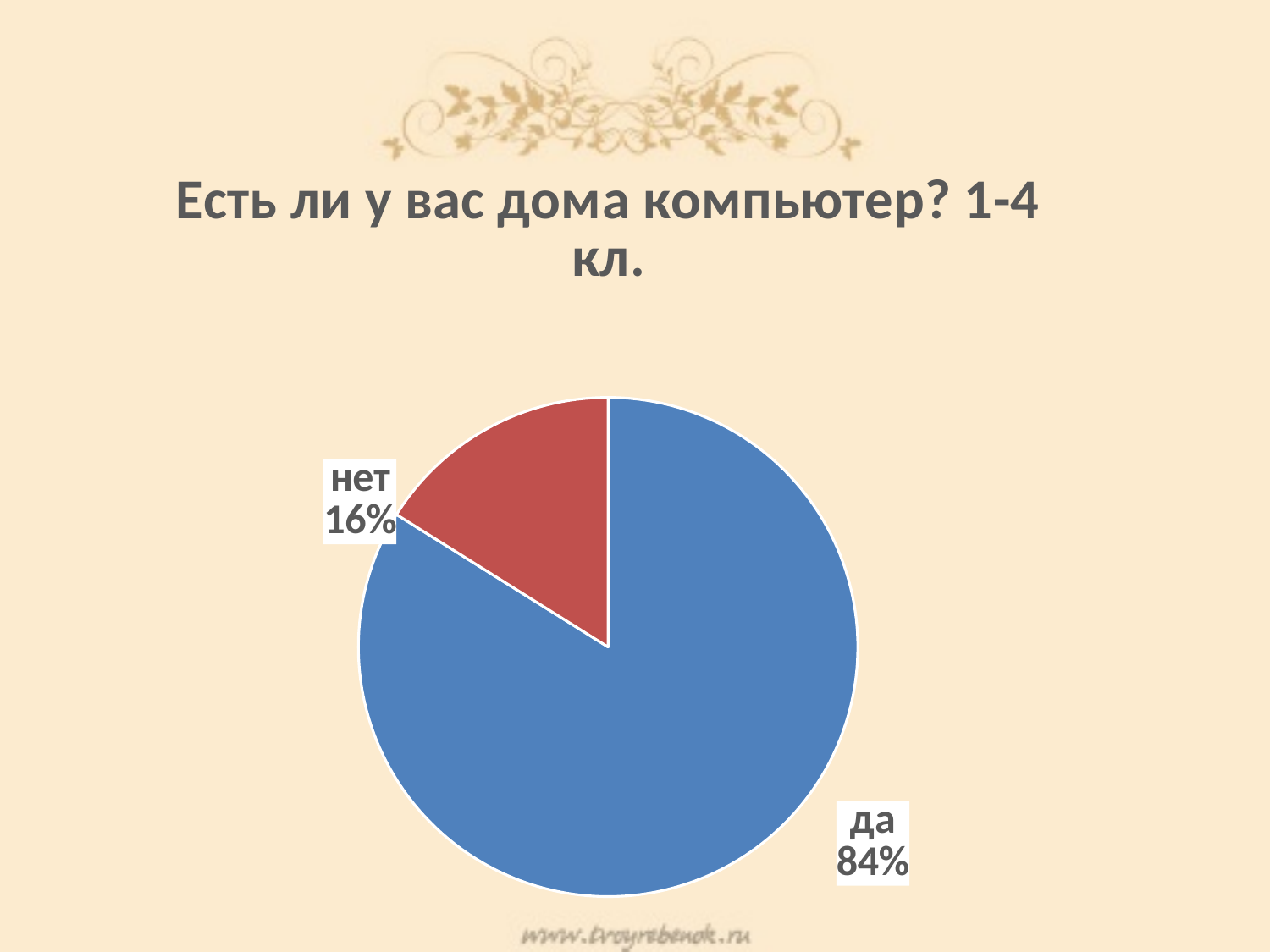
What colour is the "нет" slice? red Is the share for "да" greater or less than 50%? greater What kind of chart is shown on the slide? pie chart What share of the pie does the "нет" slice represent? 16% What is the title of the slide above the chart? Есть ли у вас дома компьютер? 1-4 кл. How many slices does the pie chart have? 2 What share of the pie does the "да" slice represent? 84% Which is larger, the "да" slice or the "нет" slice? да Which category has the largest slice of the pie? да What is the difference in percentage points between the "да" and "нет" slices? 68 Which category has the smallest slice of the pie? нет What is the total of the two slices shown? 100%